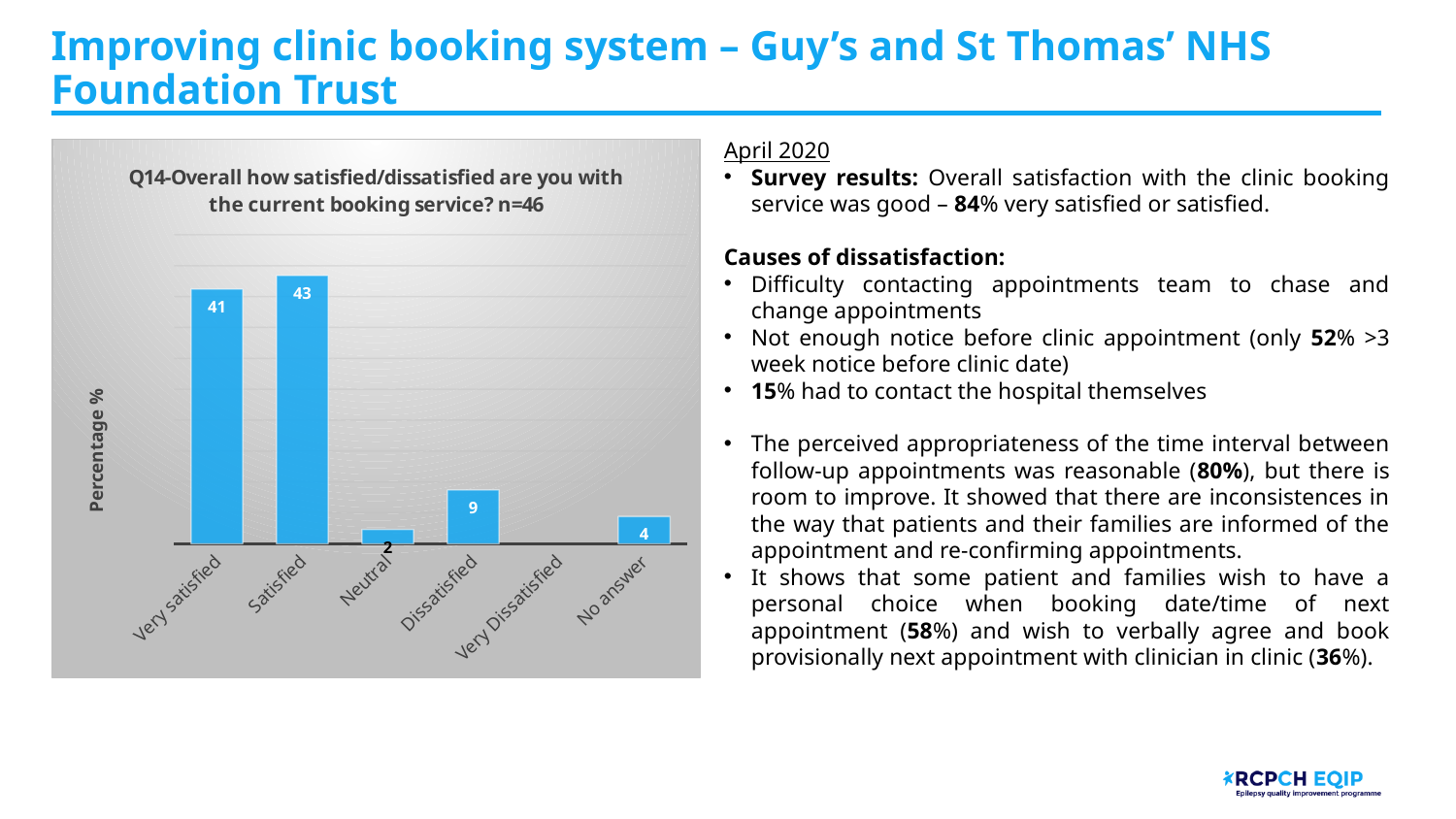
What is the value for Neutral? 2 Which category has the highest value? Satisfied What is the value for No answer? 4 What is the label of the y axis? Percentage % What kind of chart is shown on the slide? Bar chart What is the difference between the values for Dissatisfied and No answer? 5 What is the difference between the values for Satisfied and Very satisfied? 2 Which is larger, the value for Dissatisfied or the value for Neutral? Dissatisfied What is the value for Satisfied? 43 What is the value for Dissatisfied? 9 How many categories are shown on the x axis? 6 What is the value for Very satisfied? 41